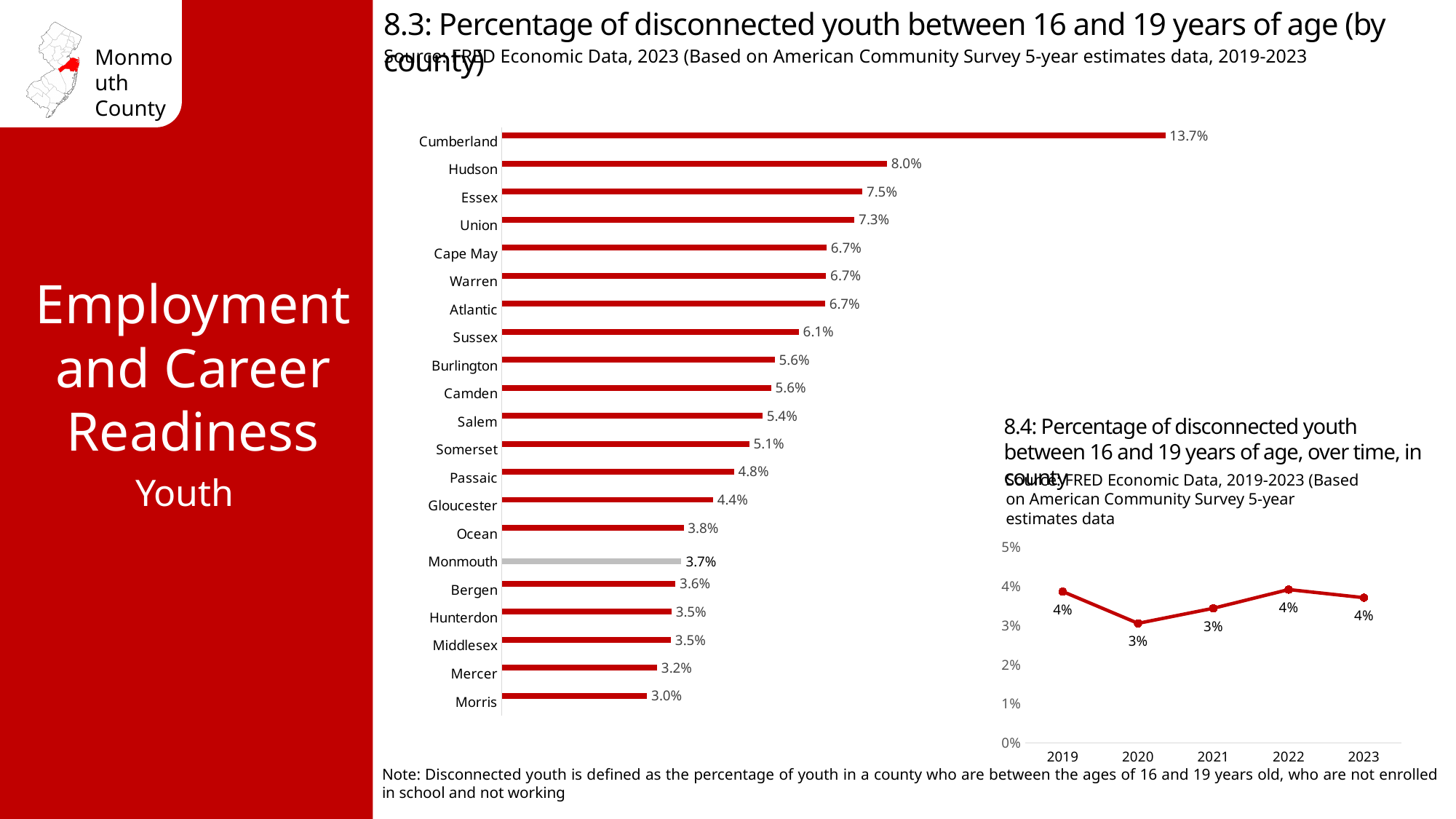
In the chart 8.3 (percentage of disconnected youth by county), which bar is shown in a different colour (grey) from the others? Monmouth In the chart 8.3 (percentage of disconnected youth by county), what is the value for Hudson? 8.0% In the chart 8.4 (disconnected youth over time in Monmouth County), what is the value for 2020? 3% In the chart 8.3 (percentage of disconnected youth by county), which county has the lowest value? Morris What kind of chart is chart 8.4 (disconnected youth over time in Monmouth County)? Line chart In the chart 8.3 (percentage of disconnected youth by county), which county has the highest value? Cumberland In the chart 8.3 (percentage of disconnected youth by county), how many counties are shown? 21 In the chart 8.3 (percentage of disconnected youth by county), what is the difference between Cumberland and Hudson? 5.7% In the chart 8.4 (disconnected youth over time in Monmouth County), how many years are plotted? 5 In the chart 8.3 (percentage of disconnected youth by county), what is the value for Monmouth? 3.7% In the chart 8.3 (percentage of disconnected youth by county), which is larger, Essex or Sussex? Essex What kind of chart is chart 8.3 (percentage of disconnected youth by county)? Bar chart